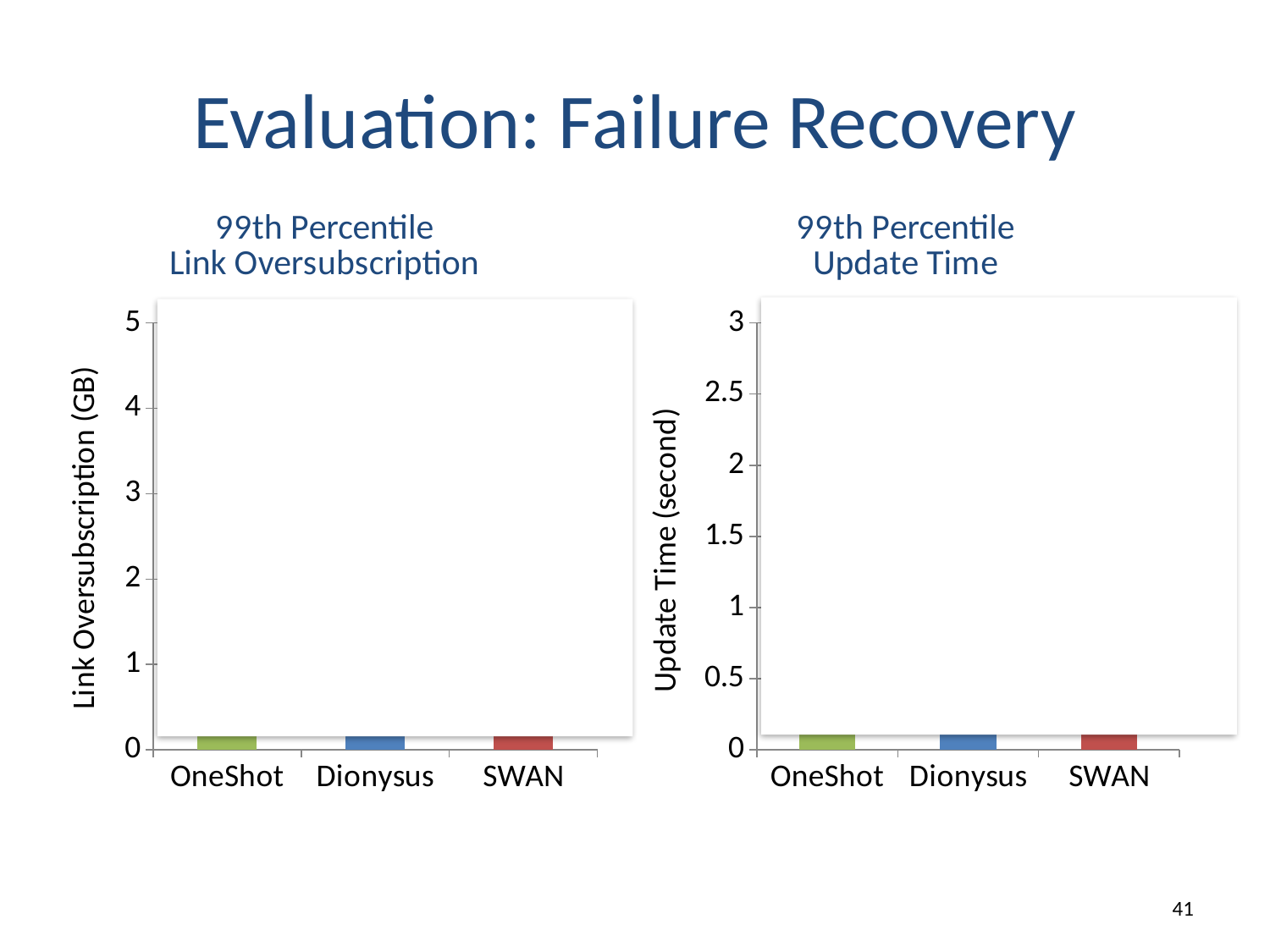
What kind of chart is the '99th Percentile Link Oversubscription' chart? bar chart What is the y-axis label of the '99th Percentile Update Time' chart? Update Time (second) In the '99th Percentile Update Time' chart, what is the highest value shown on the y axis? 3 How many categories are shown on the x axis of the '99th Percentile Update Time' chart? 3 How many categories are shown on the x axis of the '99th Percentile Link Oversubscription' chart? 3 What is the y-axis label of the '99th Percentile Link Oversubscription' chart? Link Oversubscription (GB) In the '99th Percentile Link Oversubscription' chart, what is the highest value shown on the y axis? 5 What kind of chart is the '99th Percentile Update Time' chart? bar chart